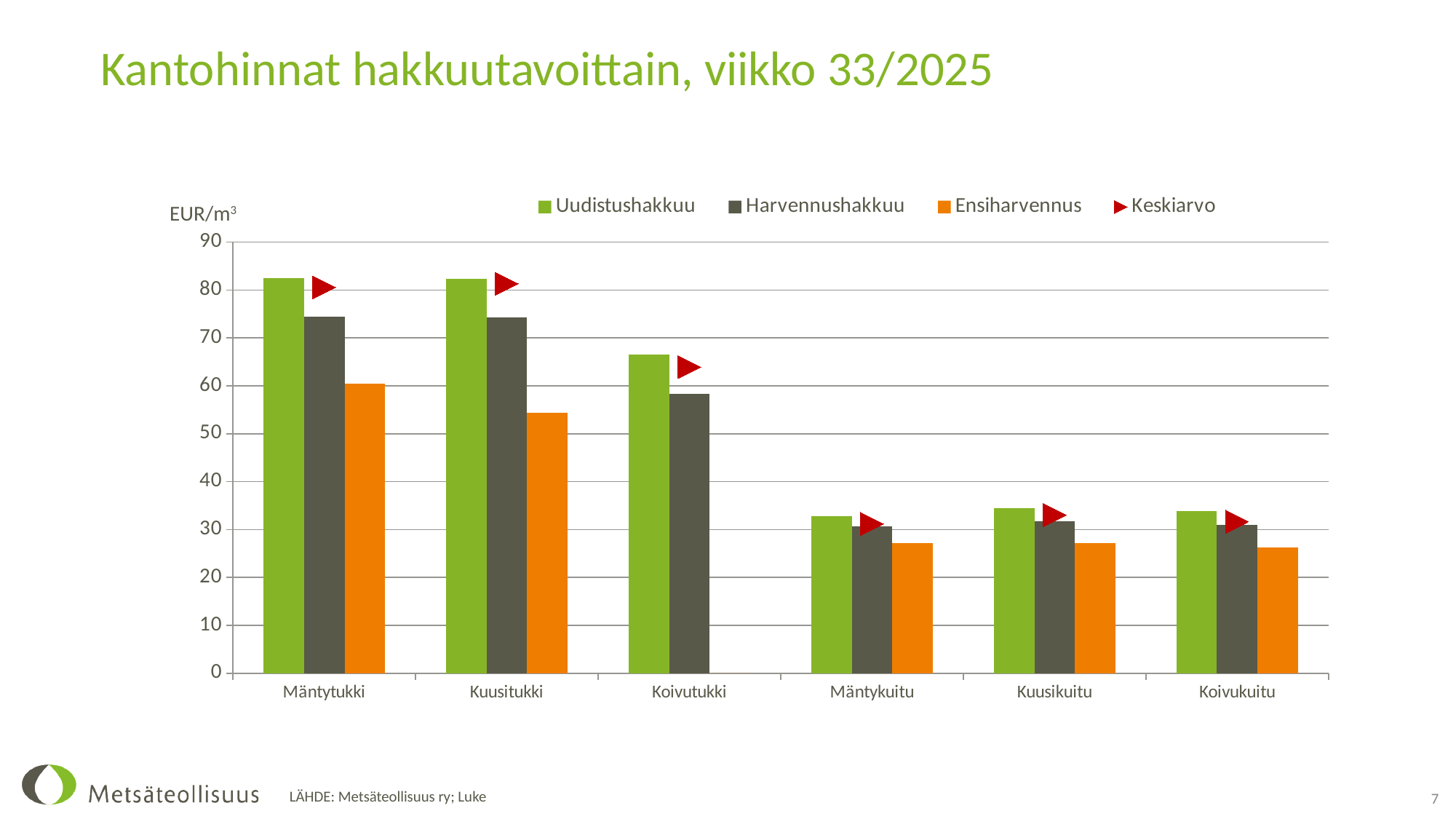
What unit is shown on the y axis? EUR/m³ Which is larger, the Uudistushakkuu value for Kuusitukki or for Koivutukki? Kuusitukki Is the Uudistushakkuu value for Koivutukki greater or less than 60? greater How many series does the legend list? 4 How many categories are shown on the x axis? 6 Is the Ensiharvennus value for Kuusitukki greater or less than 50? greater Is the Ensiharvennus value for Mäntykuitu greater or less than 30? less Which category has no Ensiharvennus bar? Koivutukki Which is larger, the Ensiharvennus value for Mäntytukki or for Kuusitukki? Mäntytukki What kind of chart is shown on the slide? bar chart